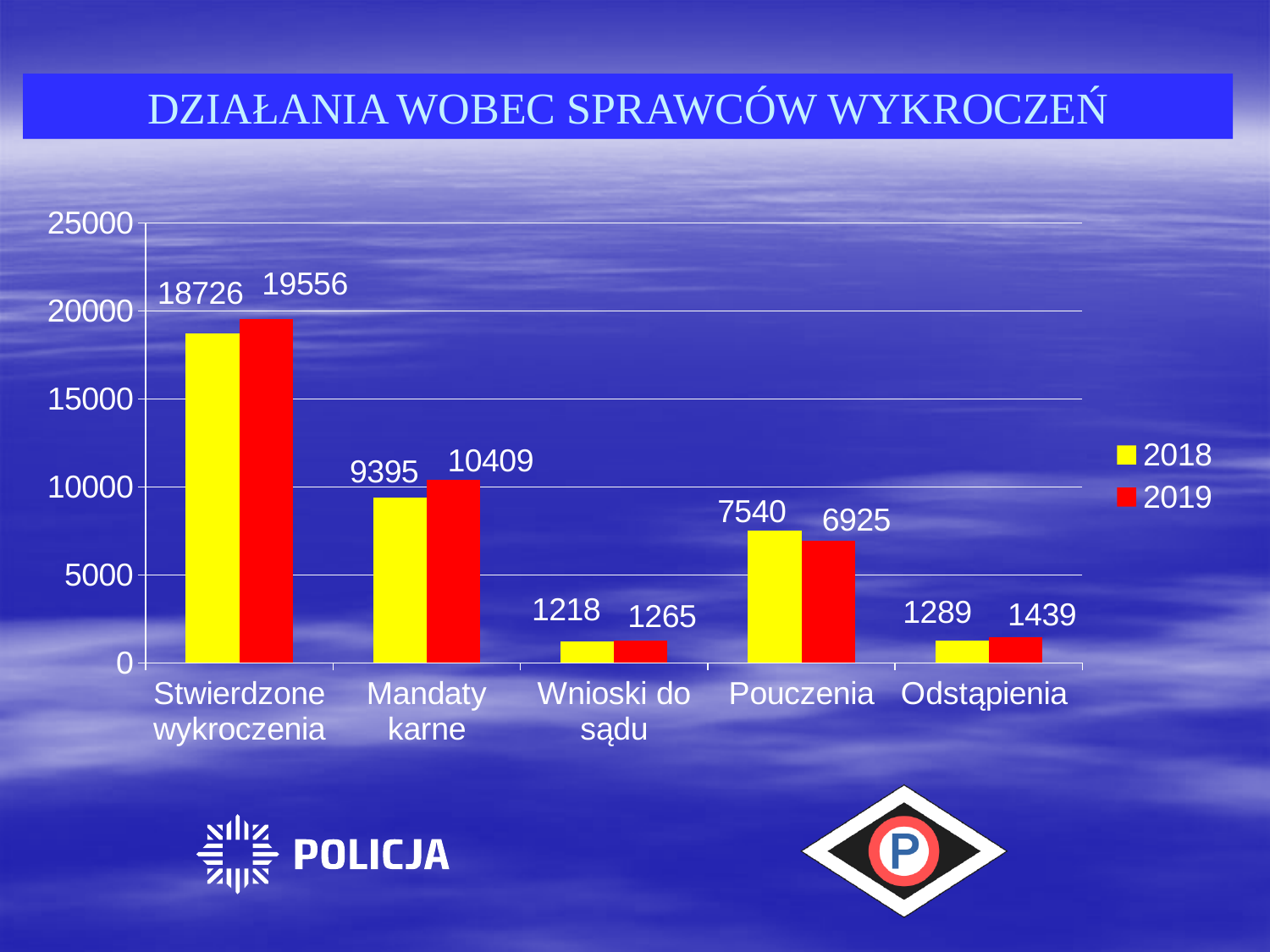
How many categories are shown on the x axis? 5 How many series does the legend list? 2 Which category has the lowest value in 2019? Wnioski do sądu What kind of chart is shown on the slide? bar chart What is the difference between the 2019 and 2018 values for Mandaty karne? 1014 Which is larger for Pouczenia, the 2018 value or the 2019 value? 2018 Which category has the highest value in 2018? Stwierdzone wykroczenia What is the value for Pouczenia in 2019? 6925 What colour represents the 2019 series? red What is the value for Stwierdzone wykroczenia in 2019? 19556 What is the value for Mandaty karne in 2018? 9395 What is the value for Wnioski do sądu in 2018? 1218